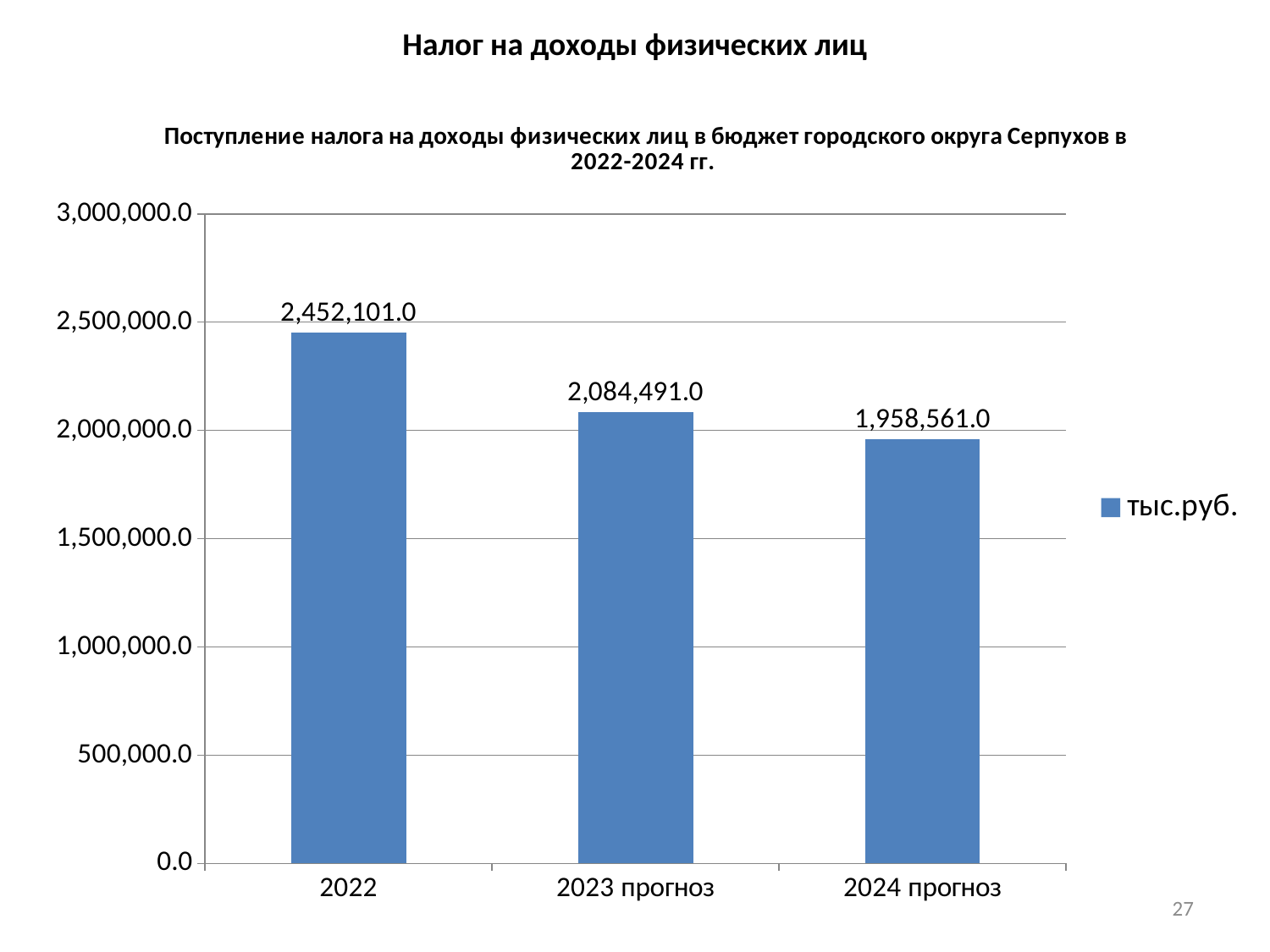
Is the value for 2024 прогноз greater or less than 2,000,000.0? less What is the value for 2023 прогноз? 2,084,491.0 What is the value for 2022? 2,452,101.0 Do the values rise or fall from 2022 to 2024 прогноз? fall What is the value for 2024 прогноз? 1,958,561.0 How many categories are shown on the x axis? 3 What is the difference between the values for 2022 and 2023 прогноз? 367,610.0 Which category has the highest value? 2022 What kind of chart is shown on the slide? bar chart What is the difference between the values for 2023 прогноз and 2024 прогноз? 125,930.0 Which category has the lowest value? 2024 прогноз Which is larger, the value for 2022 or the value for 2024 прогноз? 2022